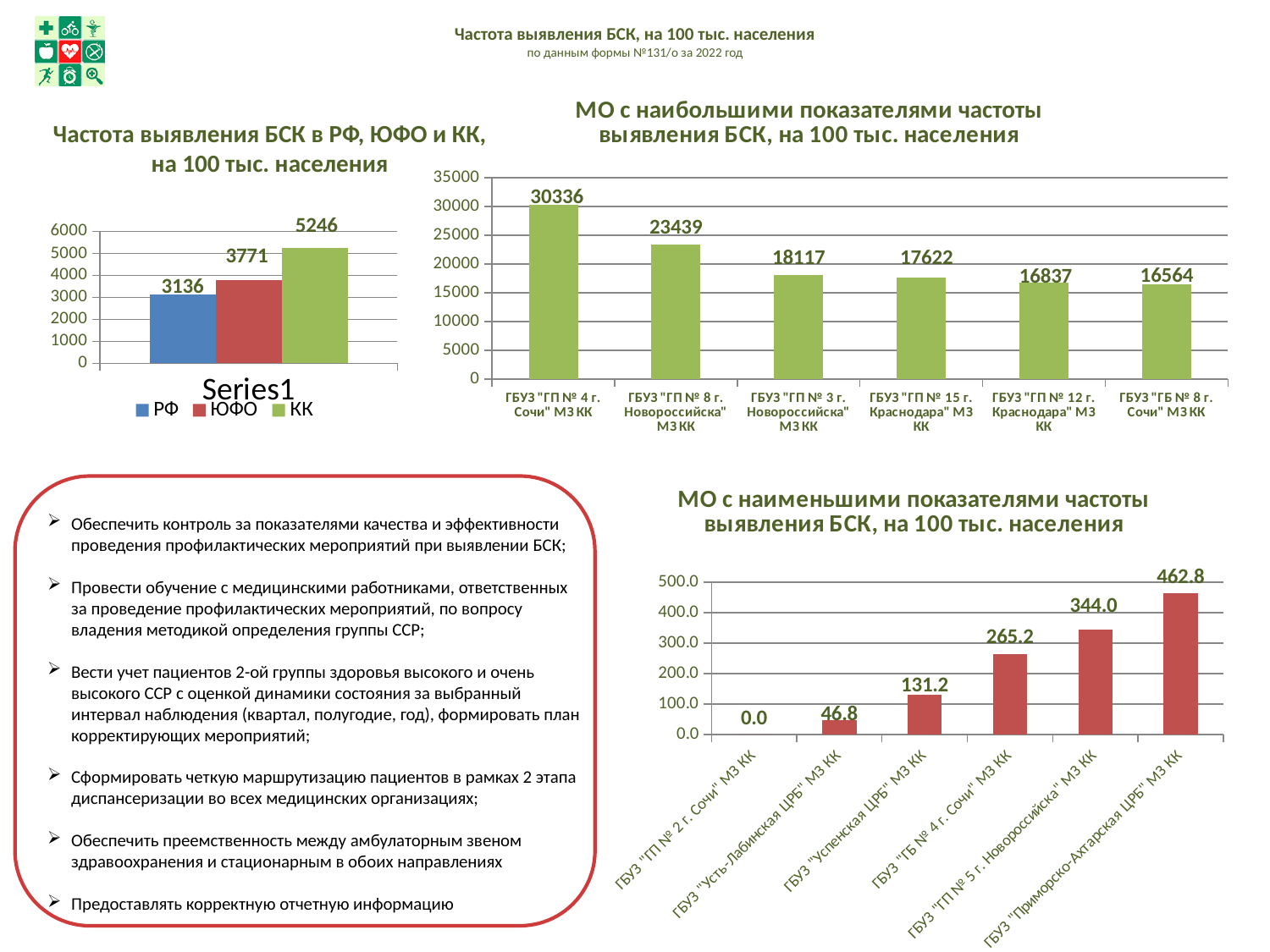
In the chart 'МО с наибольшими показателями частоты выявления БСК, на 100 тыс. населения', which organisation has the highest value? ГБУЗ "ГП № 4 г. Сочи" МЗ КК In the chart 'МО с наименьшими показателями частоты выявления БСК, на 100 тыс. населения', do the values rise or fall from left to right along the x axis? rise In the chart 'МО с наибольшими показателями частоты выявления БСК, на 100 тыс. населения', how many organisations are shown? 6 In the chart 'Частота выявления БСК в РФ, ЮФО и КК, на 100 тыс. населения', which series has the lowest value? РФ In the chart 'МО с наибольшими показателями частоты выявления БСК, на 100 тыс. населения', what is the difference between the values for ГБУЗ "ГП № 4 г. Сочи" МЗ КК and ГБУЗ "ГБ № 8 г. Сочи" МЗ КК? 13772 In the chart 'МО с наименьшими показателями частоты выявления БСК, на 100 тыс. населения', what is the value for ГБУЗ "Успенская ЦРБ" МЗ КК? 131.2 In the chart 'МО с наименьшими показателями частоты выявления БСК, на 100 тыс. населения', which is larger: the value for ГБУЗ "ГБ № 4 г. Сочи" МЗ КК or ГБУЗ "ГП № 5 г. Новороссийска" МЗ КК? ГБУЗ "ГП № 5 г. Новороссийска" МЗ КК What kind of chart is 'МО с наименьшими показателями частоты выявления БСК, на 100 тыс. населения'? bar chart In the chart 'Частота выявления БСК в РФ, ЮФО и КК, на 100 тыс. населения', what is the value for КК? 5246 In the chart 'Частота выявления БСК в РФ, ЮФО и КК, на 100 тыс. населения', what is the difference between the values for КК and РФ? 2110 In the chart 'Частота выявления БСК в РФ, ЮФО и КК, на 100 тыс. населения', how many series does the legend list? 3 In the chart 'МО с наибольшими показателями частоты выявления БСК, на 100 тыс. населения', what is the value for ГБУЗ "ГП № 8 г. Новороссийска" МЗ КК? 23439